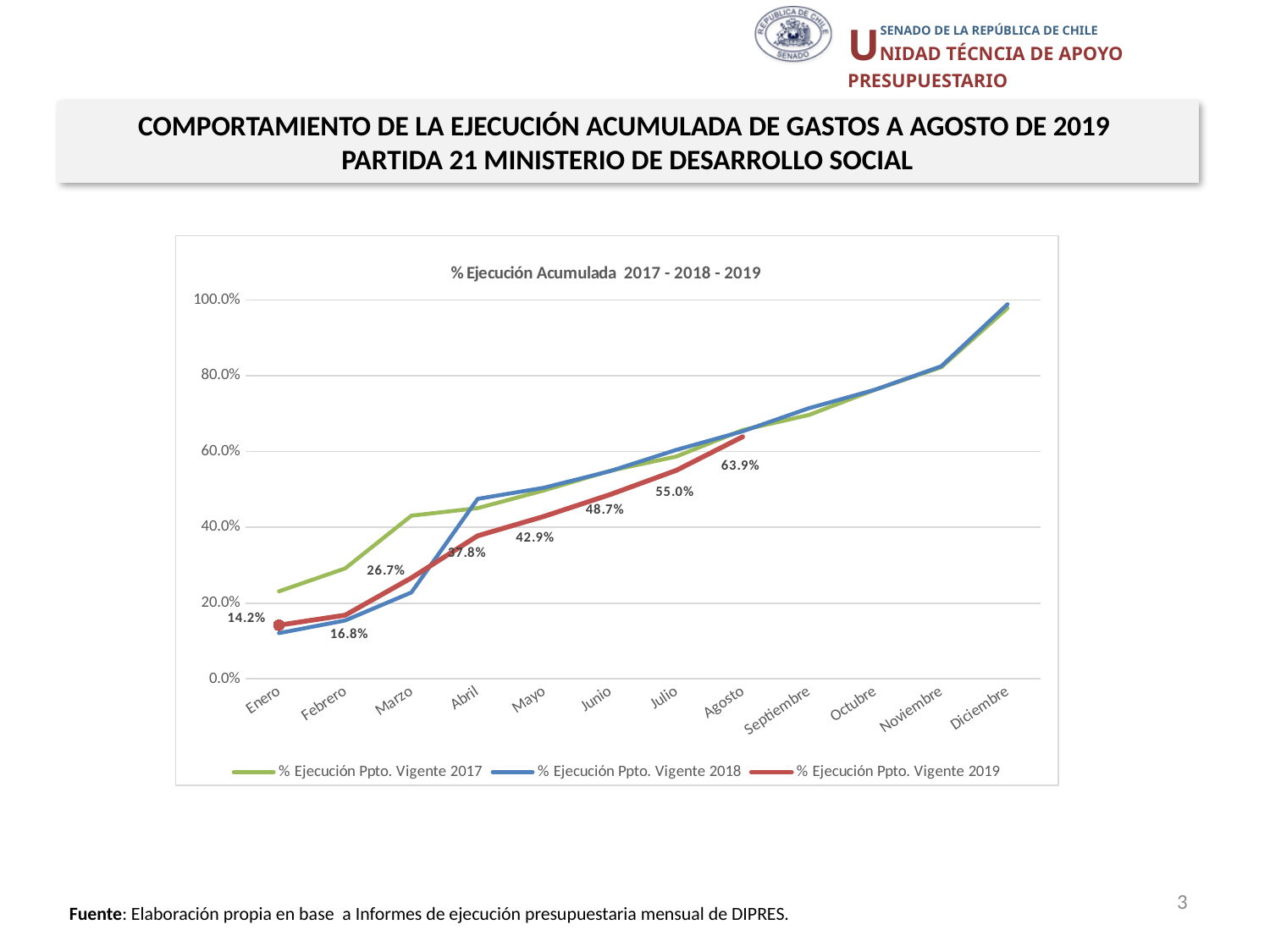
How many months are shown on the x axis? 12 What is the value of % Ejecución Ppto. Vigente 2019 for Junio? 48.7% How many series does the legend list? 3 Do the values of % Ejecución Ppto. Vigente 2019 rise or fall from Enero to Agosto? Rise What is the value of % Ejecución Ppto. Vigente 2019 for Enero? 14.2% What is the value of % Ejecución Ppto. Vigente 2019 for Abril? 37.8% By how many percentage points did % Ejecución Ppto. Vigente 2019 increase from Julio to Agosto? 8.9 percentage points Which month has the lowest labelled value for % Ejecución Ppto. Vigente 2019? Enero Is the value for % Ejecución Ppto. Vigente 2017 in Marzo greater or less than 40.0%? greater What kind of chart is shown on the slide? Line chart What is the value of % Ejecución Ppto. Vigente 2019 for Agosto? 63.9% Which month has the highest labelled value for % Ejecución Ppto. Vigente 2019? Agosto